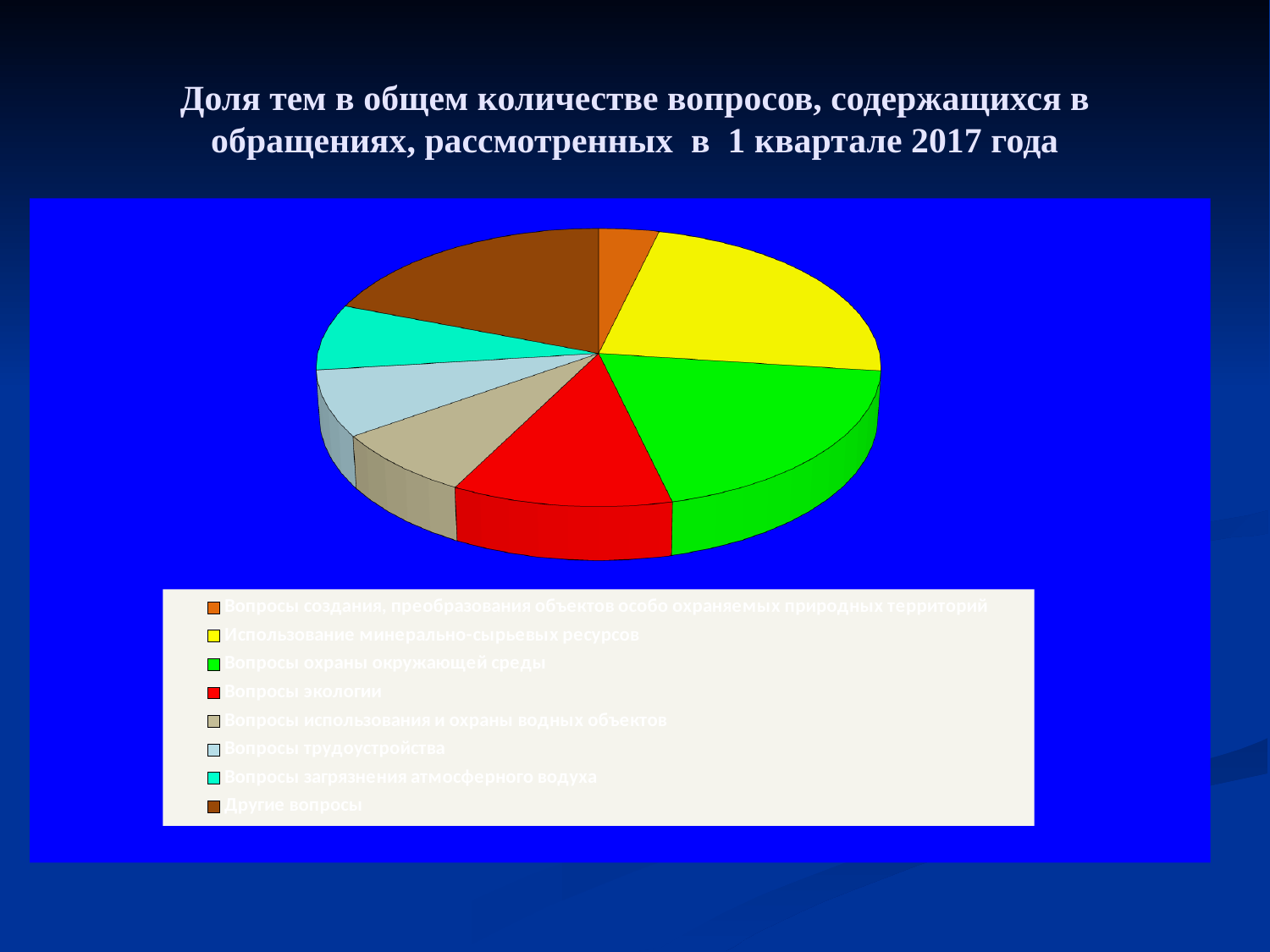
Which slice is larger: Вопросы охраны окружающей среды or Вопросы использования и охраны водных объектов? Вопросы охраны окружающей среды How many categories (slices) does the pie chart have? 8 What kind of chart is shown on the slide? pie chart Which slice is larger: Другие вопросы or Вопросы загрязнения атмосферного воздуха? Другие вопросы Which category is shown in yellow in the pie chart? Использование минерально-сырьевых ресурсов Which category has the smallest slice in the pie chart? Вопросы создания, преобразования объектов особо охраняемых природных территорий Which slice is larger: Вопросы экологии or Вопросы трудоустройства? Вопросы экологии Which category has the largest slice in the pie chart? Использование минерально-сырьевых ресурсов What colour represents Вопросы экологии in the pie chart? red